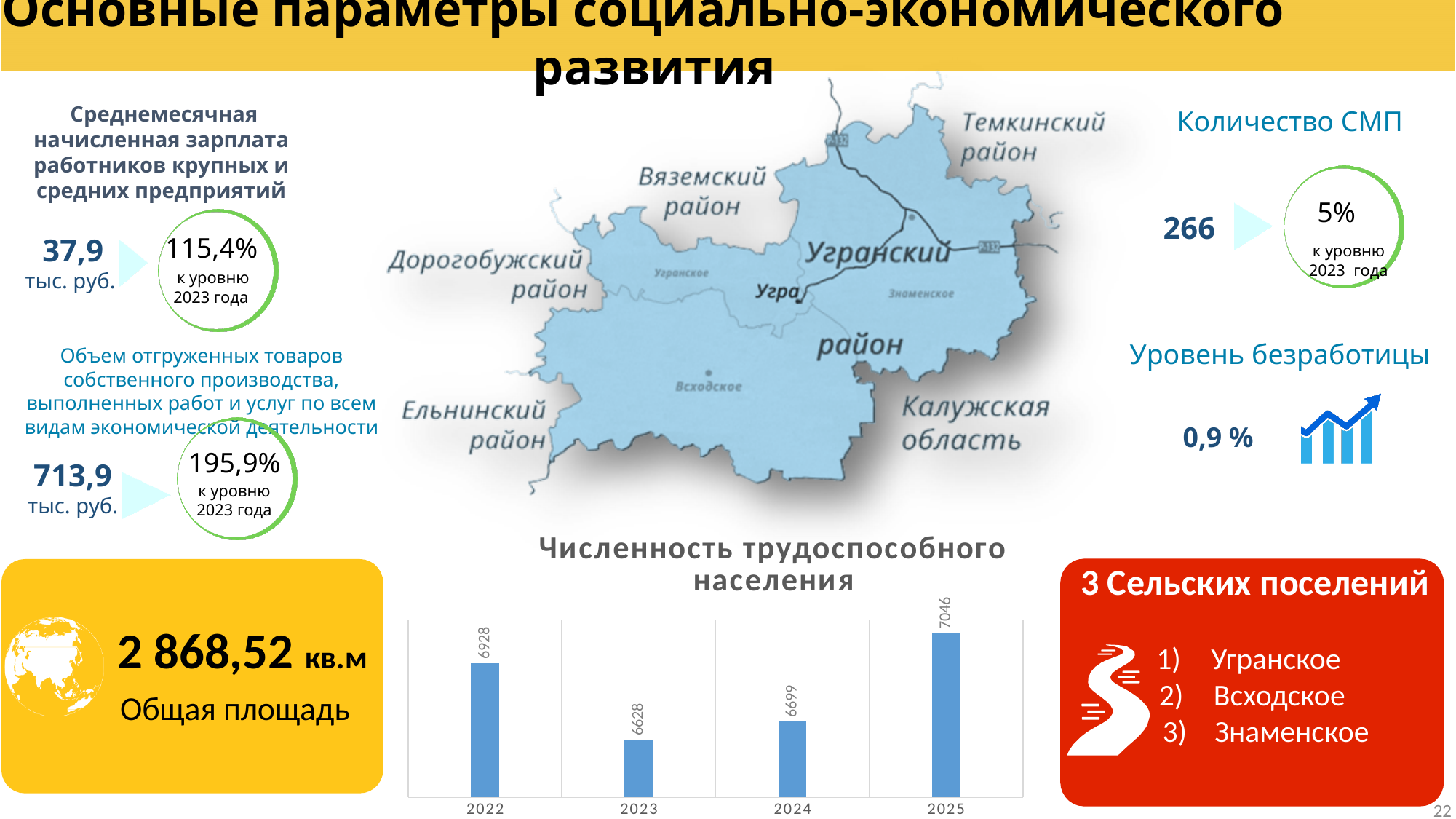
In the 'Численность трудоспособного населения' chart, what is the difference between the values for 2025 and 2022? 118 In the 'Численность трудоспособного населения' chart, do the values rise or fall from 2023 to 2025? rise How many years are shown in the 'Численность трудоспособного населения' chart? 4 What is the value for 2025 in the 'Численность трудоспособного населения' chart? 7046 In the 'Численность трудоспособного населения' chart, what is the difference between the values for 2022 and 2023? 300 In the 'Численность трудоспособного населения' chart, which is larger: the value for 2024 or the value for 2023? 2024 What kind of chart is 'Численность трудоспособного населения'? bar chart Which year has the lowest value in the 'Численность трудоспособного населения' chart? 2023 Which year has the highest value in the 'Численность трудоспособного населения' chart? 2025 What is the value for 2022 in the 'Численность трудоспособного населения' chart? 6928 What is the value for 2023 in the 'Численность трудоспособного населения' chart? 6628 What is the value for 2024 in the 'Численность трудоспособного населения' chart? 6699